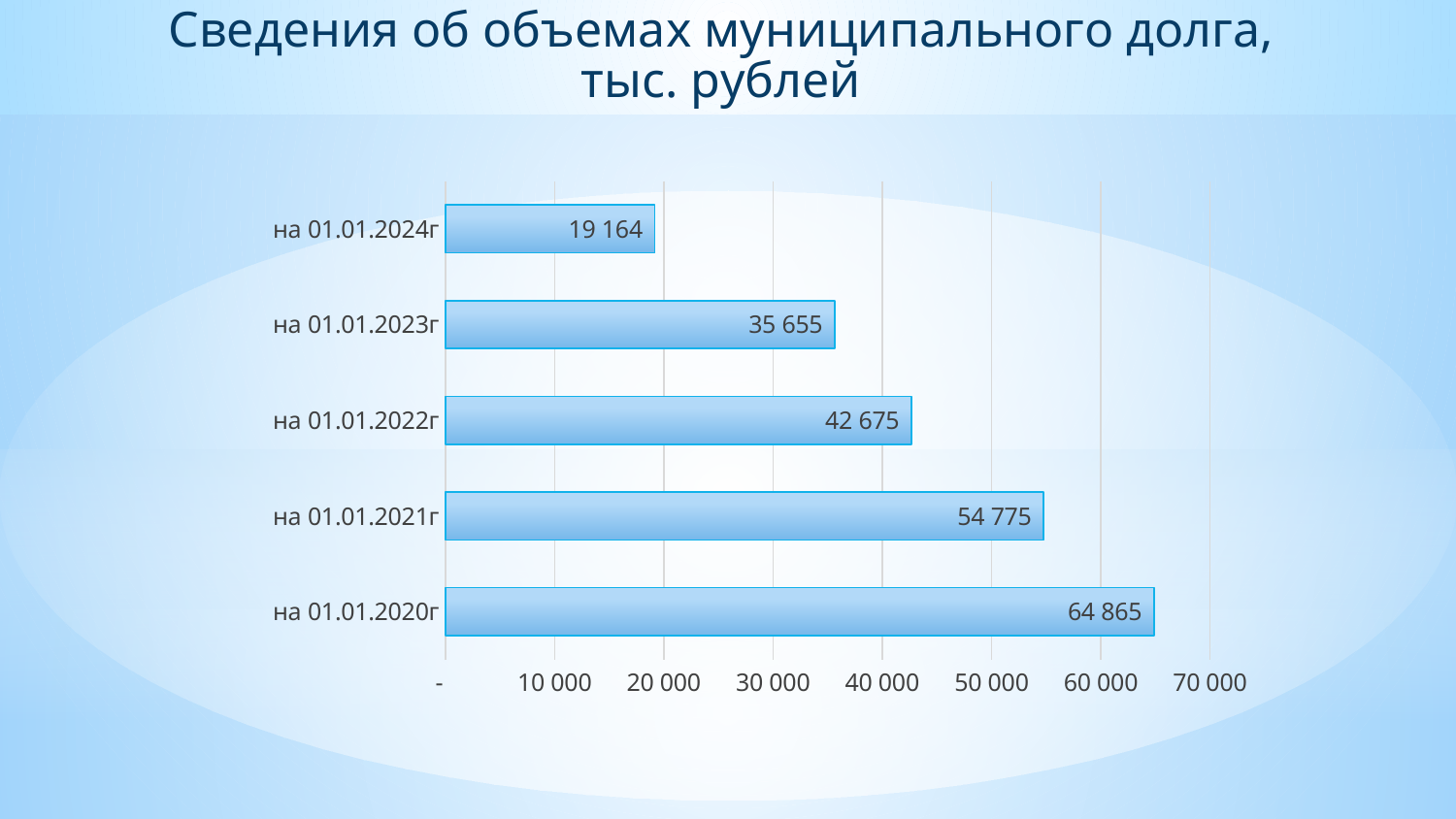
Which category has the lowest value? на 01.01.2024г What is the value for на 01.01.2024г? 19 164 Is the value for на 01.01.2021г greater or less than 50 000? greater What is the value for на 01.01.2022г? 42 675 Do the values rise or fall from на 01.01.2020г to на 01.01.2024г? fall How many categories are shown in the chart? 5 What is the difference between the values for на 01.01.2020г and на 01.01.2024г? 45 701 What is the difference between the values for на 01.01.2021г and на 01.01.2022г? 12 100 Which category has the highest value? на 01.01.2020г What is the value for на 01.01.2021г? 54 775 Which is larger, the value for на 01.01.2023г or the value for на 01.01.2022г? на 01.01.2022г What kind of chart is shown on the slide? bar chart